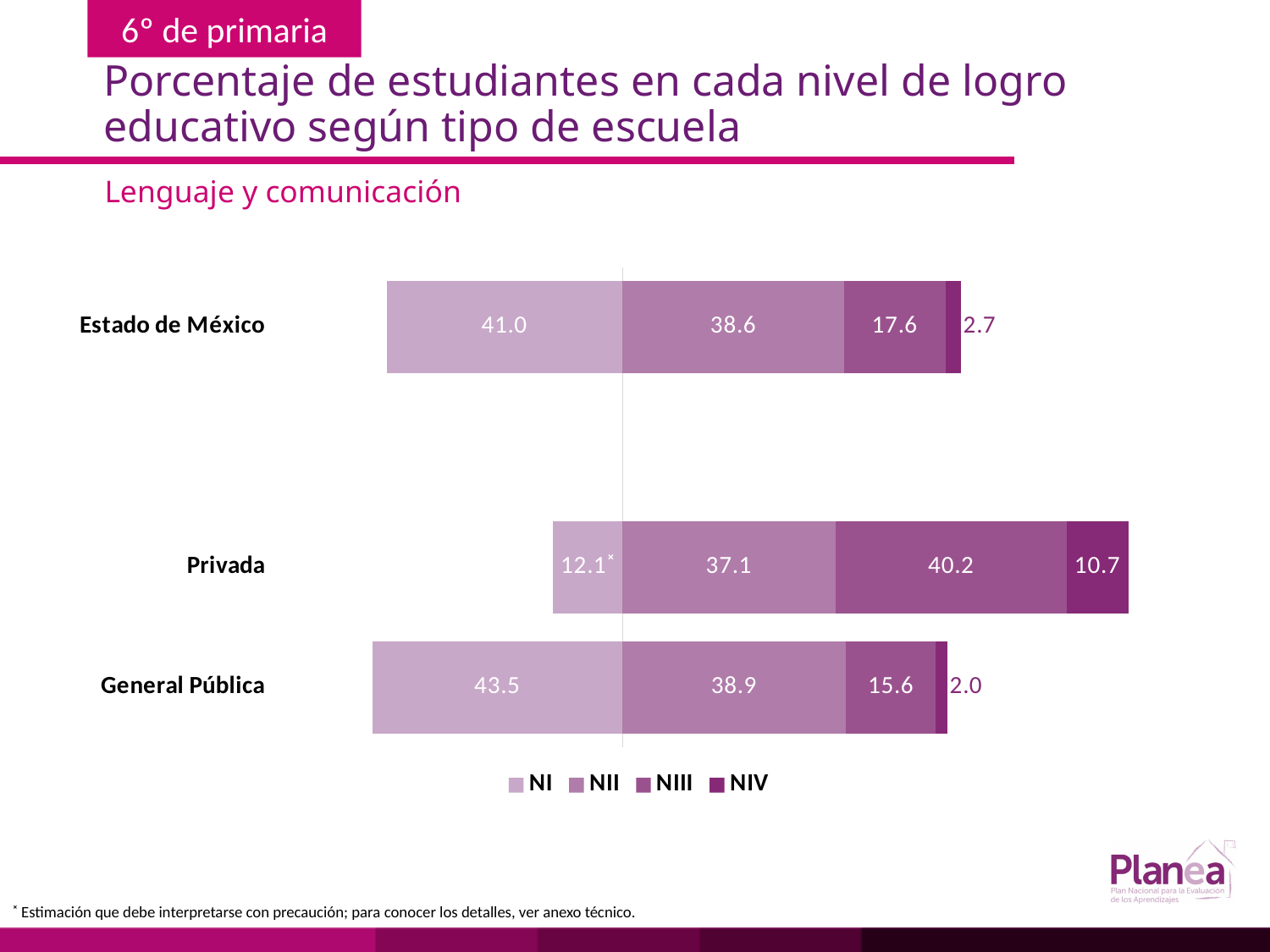
Which category has the highest NI value? General Pública What is the NI value for Estado de México? 41.0 What is the NIII value for Privada? 40.2 What kind of chart is shown on the slide? stacked bar chart How many series does the legend list? 4 How many school-type categories are plotted in the chart? 3 What is the total of the stacked bar for General Pública? 100.0 What is the difference between the NIV values for Privada and Estado de México? 8.0 Which category has the lowest NIV value? General Pública Which is larger, the NIII value for Estado de México or the NIII value for General Pública? Estado de México What is the NII value for General Pública? 38.9 What is the NIV value for General Pública? 2.0